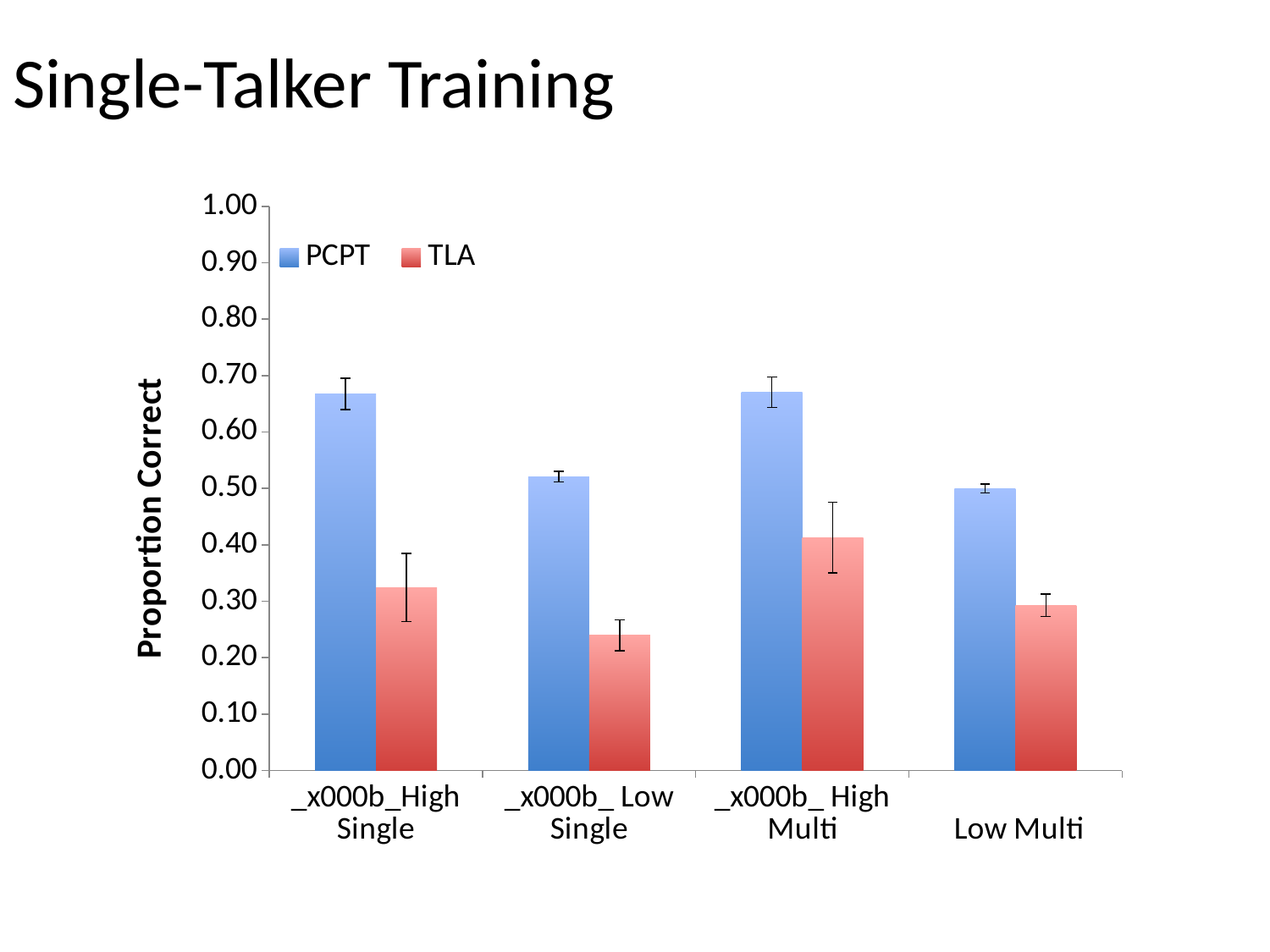
Is the PCPT value for High Single greater or less than 0.60? greater Is the TLA value for Low Single greater or less than 0.30? less Is the TLA value for Low Multi greater or less than 0.20? greater What kind of chart is shown on the slide? bar chart How many categories are shown on the x axis? 4 What is the y-axis title of the chart? Proportion Correct For the High Single category, which series has the larger value, PCPT or TLA? PCPT For which category is the TLA value highest? High Multi Which series is shown in red in the legend? TLA How many series does the legend list? 2